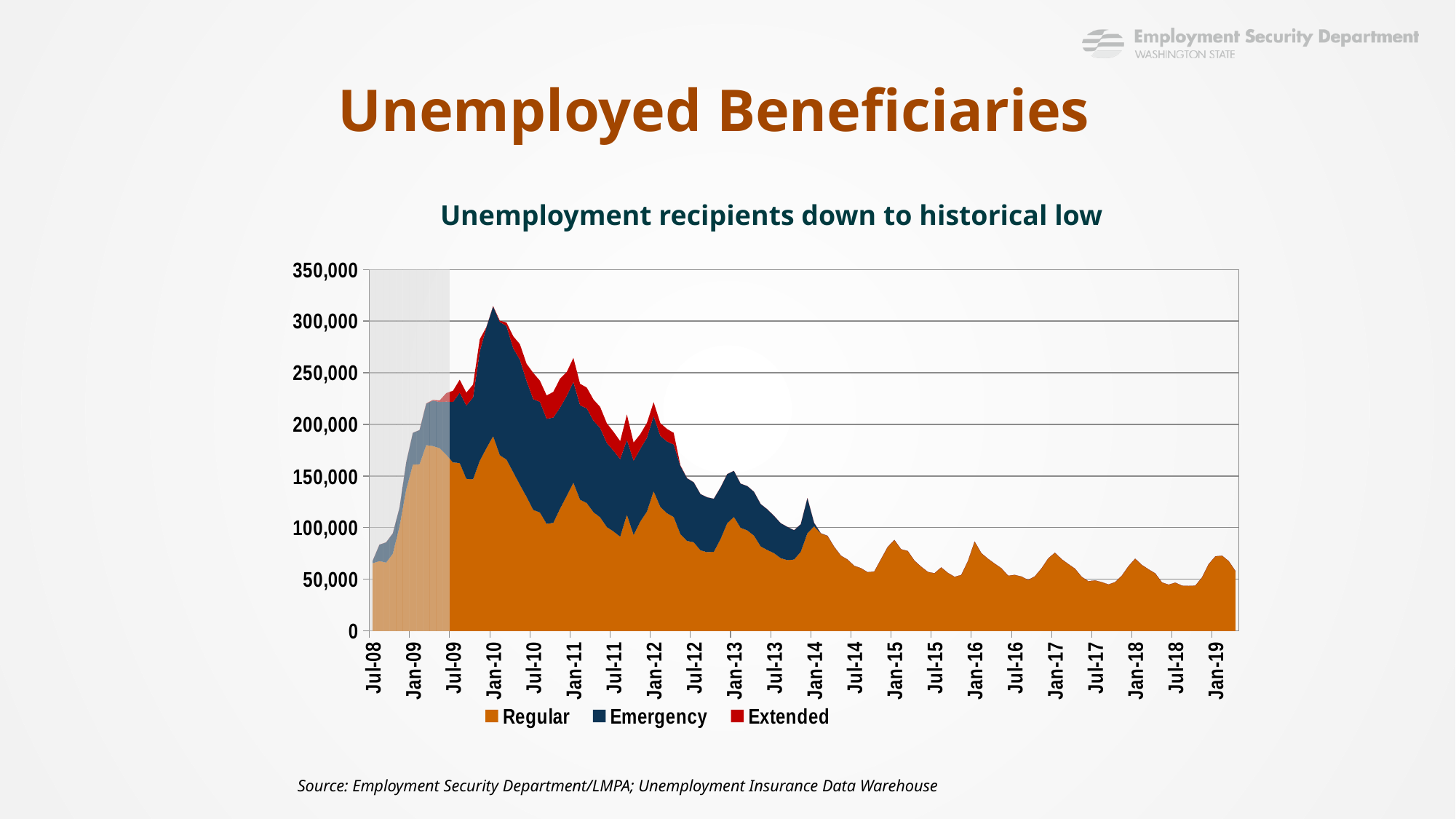
Overall, do the total beneficiaries rise or fall from Jan-10 to Jan-19? fall Around which x-axis label does the total number of beneficiaries reach its peak? Jan-10 What is the subtitle shown above the chart? Unemployment recipients down to historical low Is the total number of beneficiaries around Jan-10 greater or less than 250,000? greater What are the three series named in the legend? Regular, Emergency, Extended How many series does the legend list? 3 Is the total number of beneficiaries at Jul-08 greater or less than 100,000? less What is the highest value shown on the vertical axis? 350,000 What kind of chart is shown on the slide? Stacked area chart Is the total number of beneficiaries at Jan-19 greater or less than 100,000? less Which is larger, the total number of beneficiaries at Jan-10 or at Jan-19? Jan-10